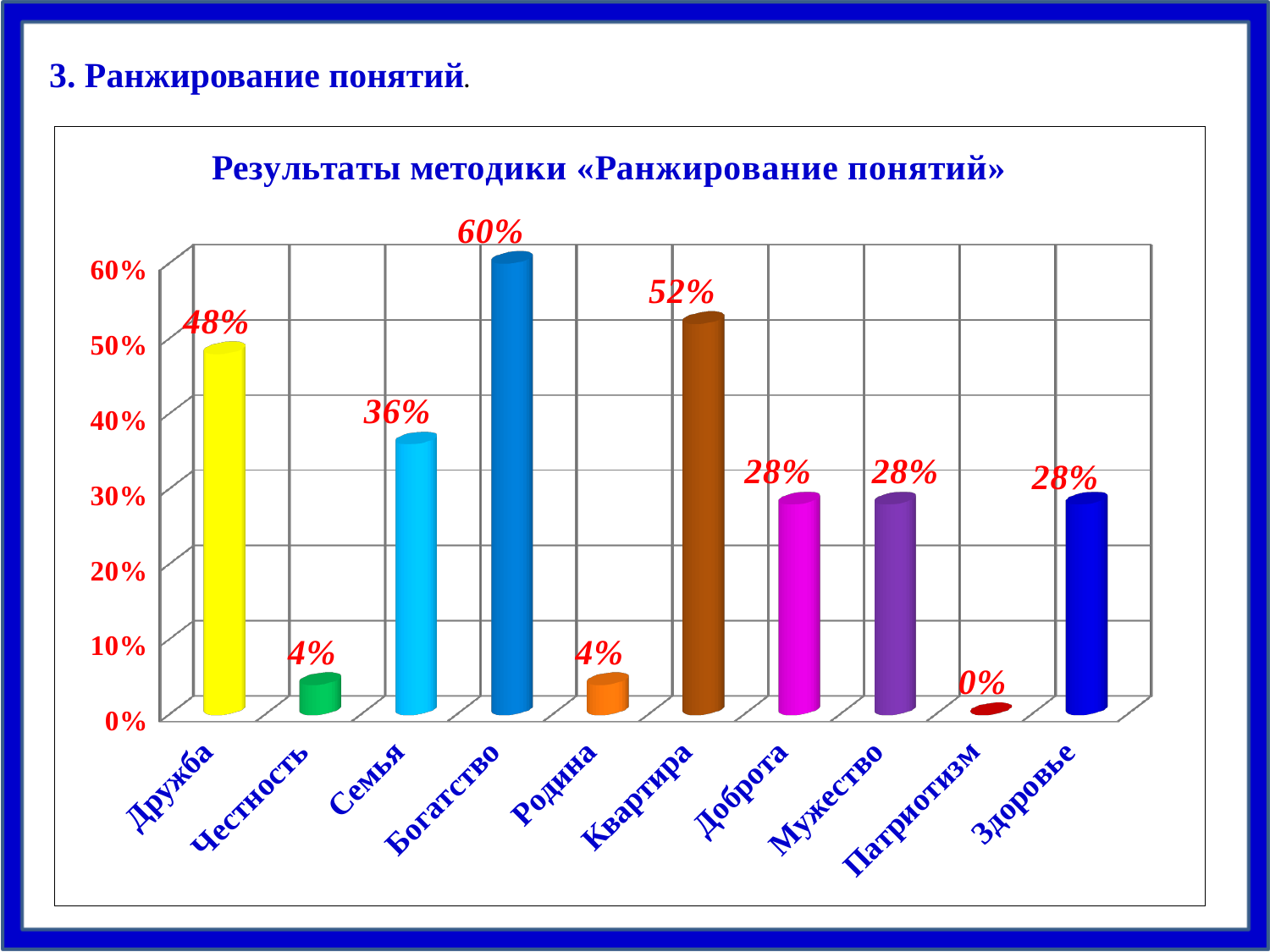
How many categories are shown on the x axis? 10 What is the value for Дружба? 48% Is the value for Семья greater or less than 30%? greater What is the difference between the values for Богатство and Семья? 24% Which category has the highest value? Богатство What is the value for Квартира? 52% What is the title of the chart? Результаты методики «Ранжирование понятий» Which is larger, the value for Дружба or the value for Квартира? Квартира Which category has the lowest value? Патриотизм What kind of chart is shown? bar chart What is the value for Патриотизм? 0% How many categories have a value of 28%? 3